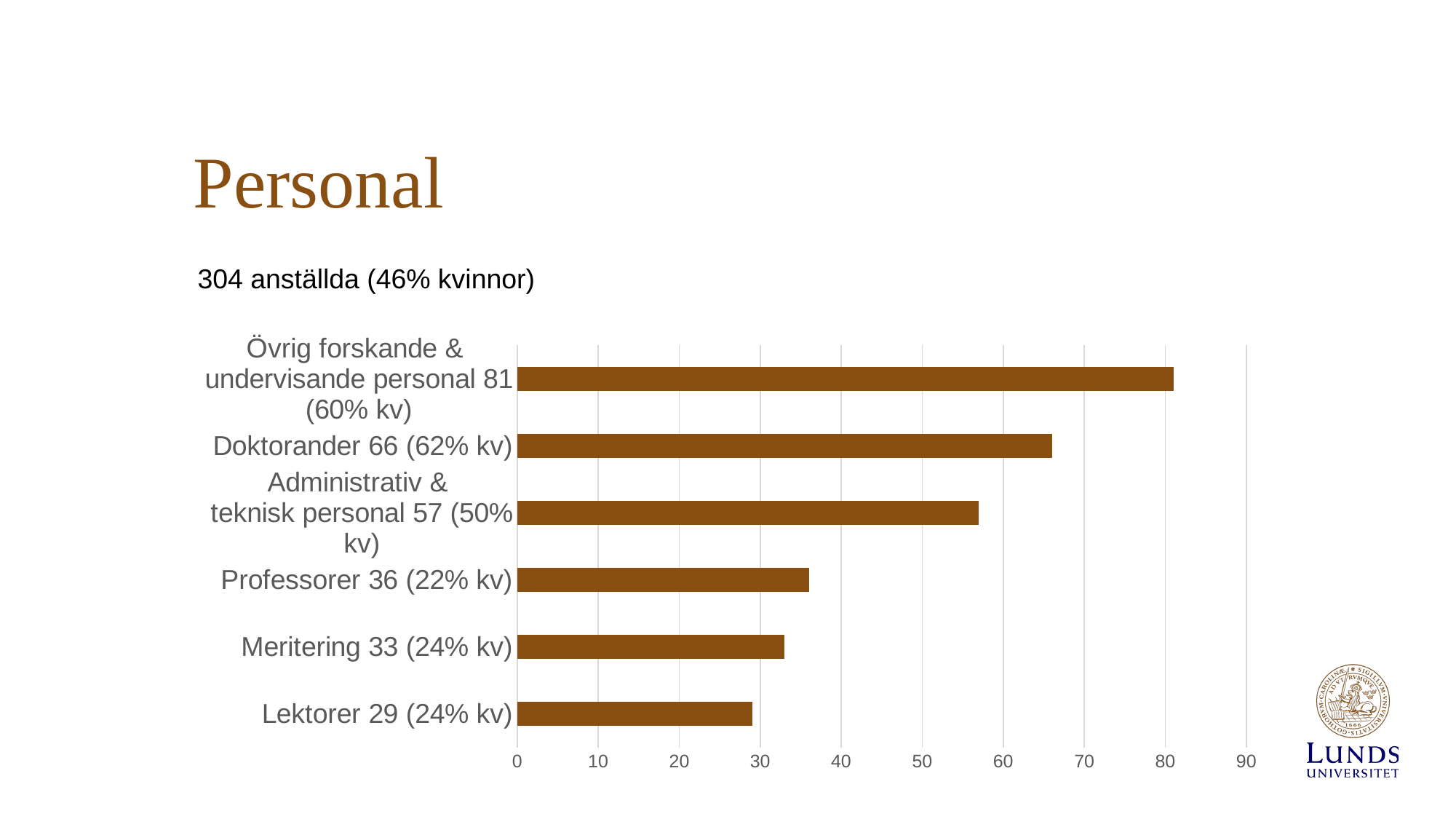
What is the value for Administrativ & teknisk personal? 57 Is the value for Övrig forskande & undervisande personal greater or less than 80? greater Which category has the lowest value in the bar chart? Lektorer How many categories does the bar chart show? 6 What is the difference between the values for Doktorander and Lektorer? 37 Which category has the highest value in the bar chart? Övrig forskande & undervisande personal What kind of chart is shown on the slide? bar chart What is the title of the slide containing the chart? Personal What is the value for Professorer? 36 Which is larger, the value for Meritering or the value for Professorer? Professorer What is the value for Doktorander? 66 What percentage of women (kv) is given for Professorer in the category label? 22%